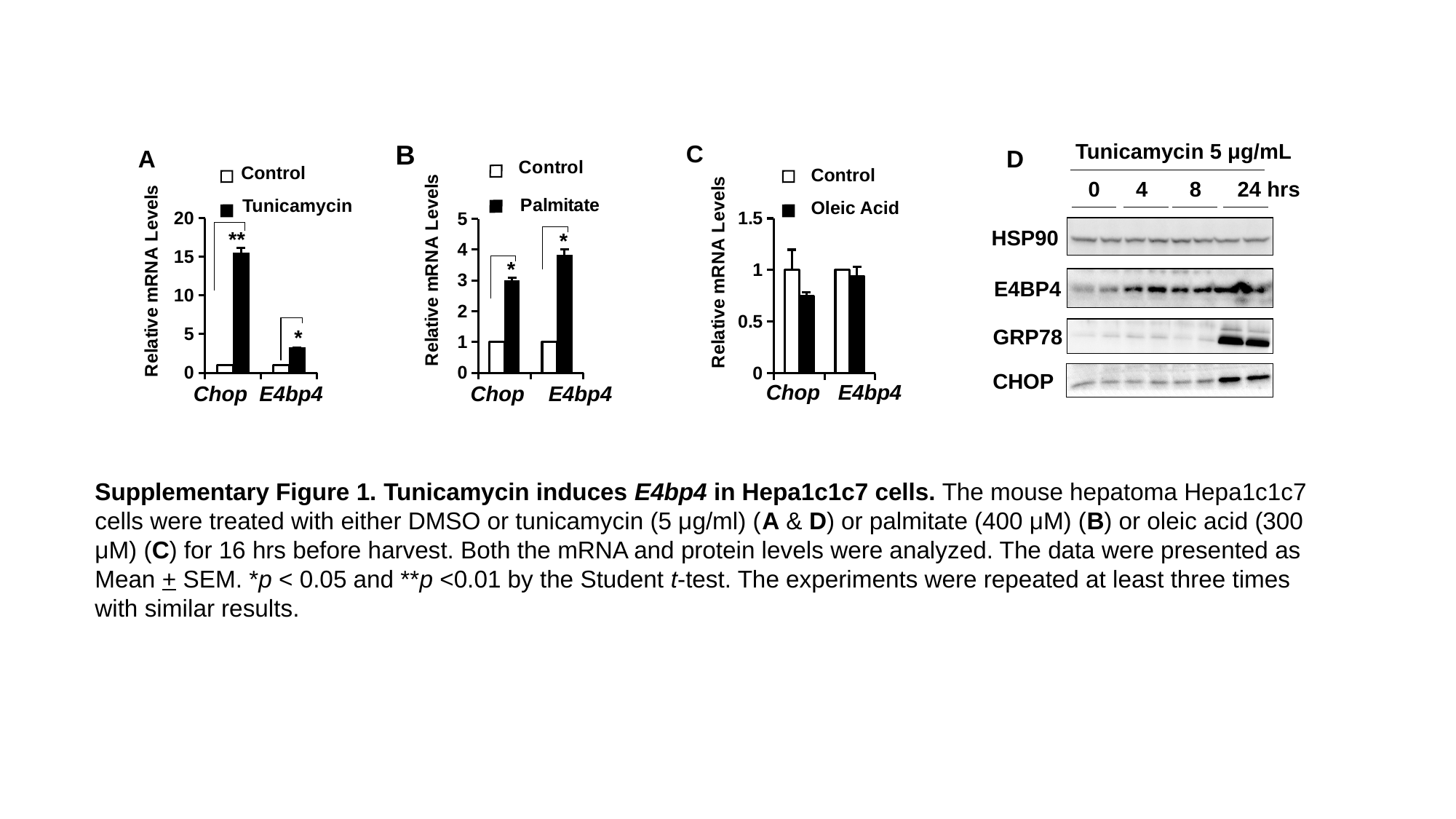
How many series does the legend of chart B list? 2 What kind of chart is chart A? bar chart In chart B, is the Palmitate value for E4bp4 greater or less than 3? greater In chart C, which is larger for Chop: the Control value or the Oleic Acid value? Control In chart A, which bar is the highest? Tunicamycin for Chop In chart B, what is the Control value for Chop? 1 In chart C, is the Oleic Acid value for Chop greater or less than 1? less How many categories are shown on the x axis of chart C? 2 In chart B, which is larger: the Palmitate value for Chop or the Palmitate value for E4bp4? E4bp4 In chart A, is the Tunicamycin value for E4bp4 greater or less than 5? less What are the two legend entries in chart A? Control and Tunicamycin